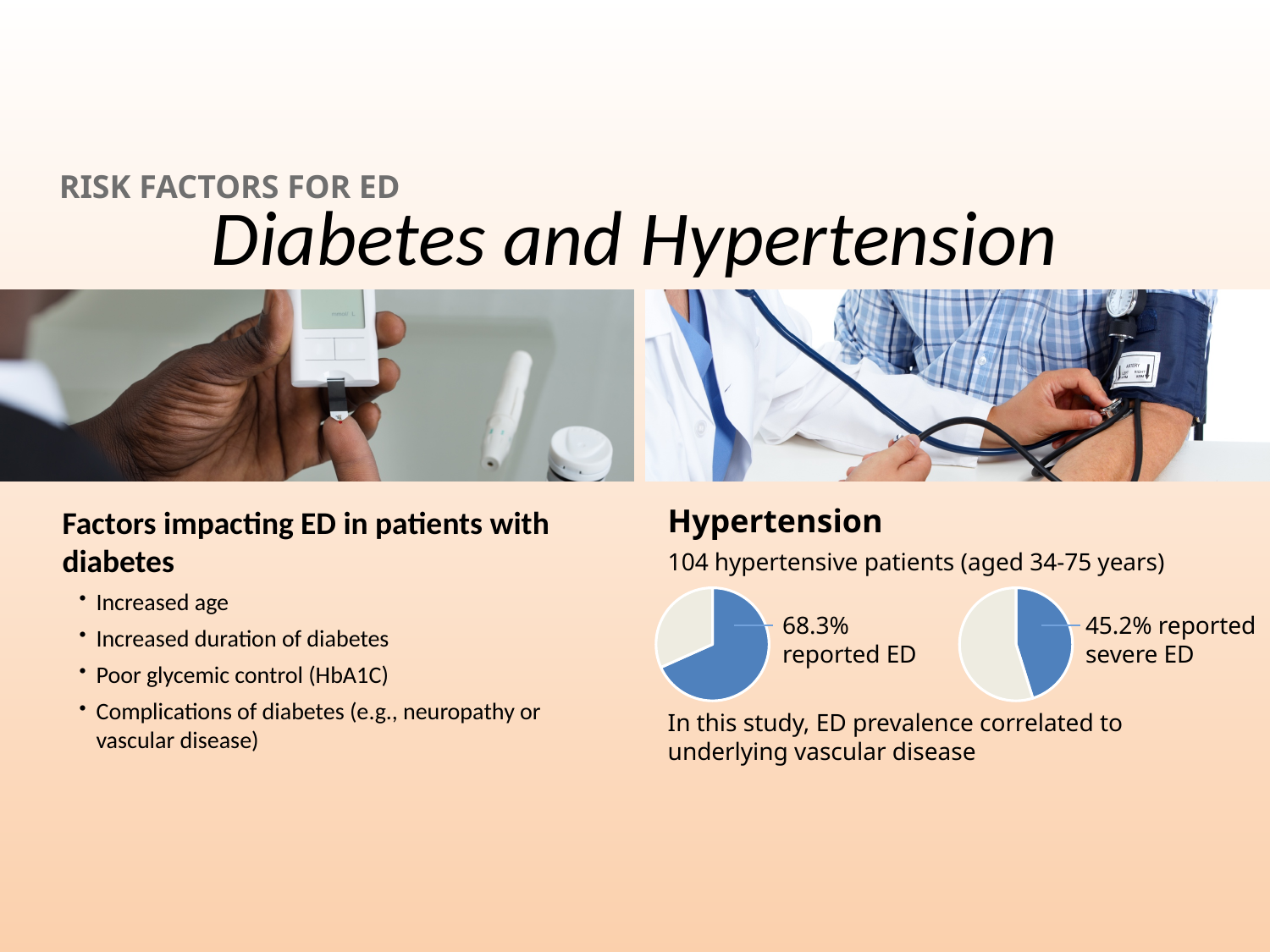
What is the difference in percentage points between the share that reported ED (left pie chart) and the share that reported severe ED (right pie chart)? 23.1 percentage points What kind of chart is the right chart under the Hypertension heading? Pie chart What kind of chart is the left chart under the Hypertension heading? Pie chart In the left pie chart, is the labelled slice for patients who reported ED greater or less than 50%? greater In the left pie chart, what percentage of hypertensive patients reported ED? 68.3% In the right pie chart, what percentage of hypertensive patients reported severe ED? 45.2% How many slices does each pie chart on the slide have? 2 Which is larger: the share that reported ED in the left pie chart or the share that reported severe ED in the right pie chart? Reported ED (68.3%) According to the text above the pie charts, how many hypertensive patients were in the study? 104 In the right pie chart, is the labelled slice for patients who reported severe ED greater or less than 50%? less How many pie charts are shown on the slide? 2 What colour is the labelled slice in each pie chart? Blue